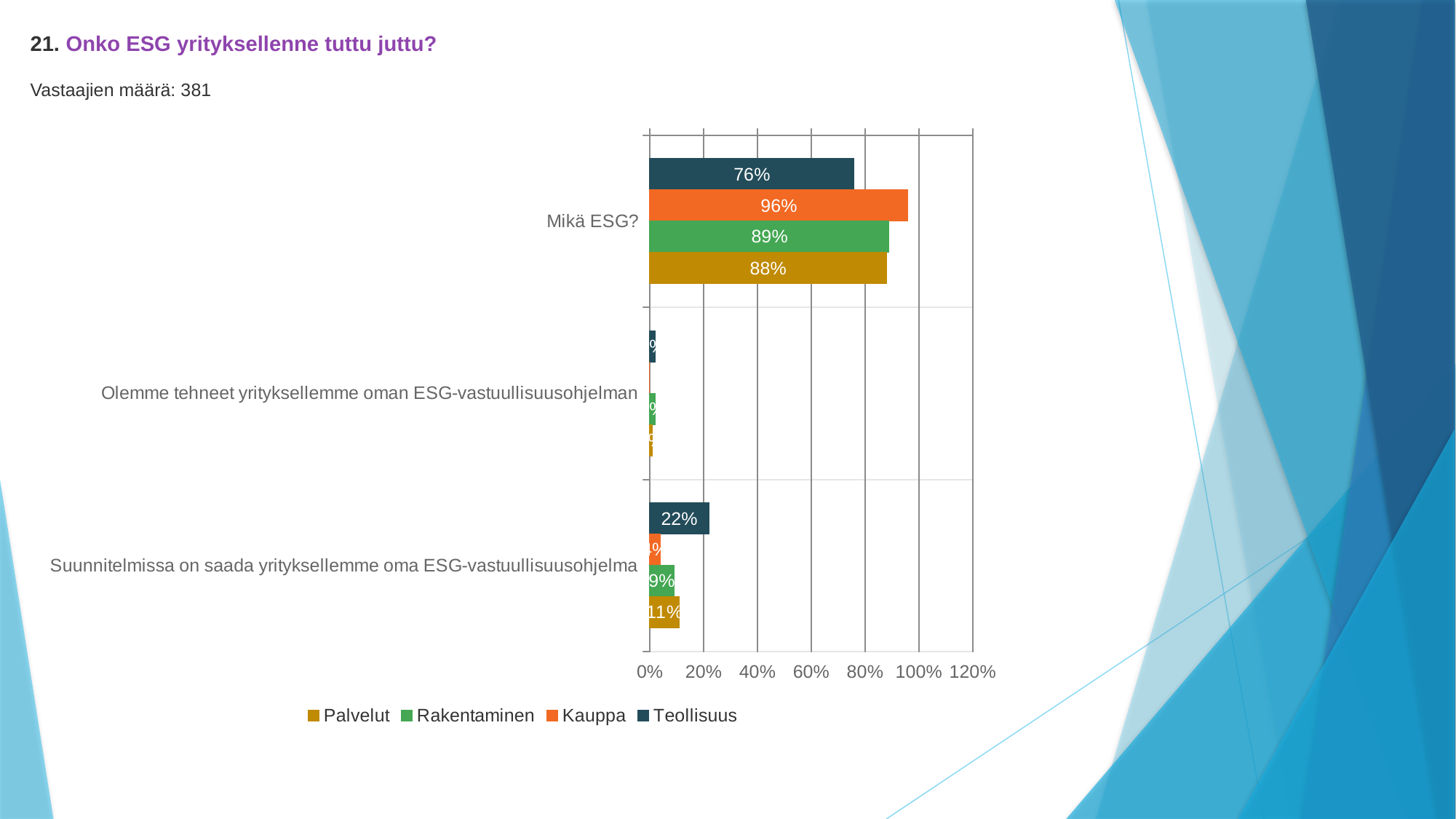
What is the difference between the Kauppa and Teollisuus values in the category "Mikä ESG?"? 20% Which series has the lowest value in the category "Mikä ESG?"? Teollisuus What is the value for Teollisuus in the category "Mikä ESG?"? 76% What is the value for Kauppa in the category "Mikä ESG?"? 96% Is the value for Teollisuus in the category "Suunnitelmissa on saada yrityksellemme oma ESG-vastuullisuusohjelma" greater or less than 40%? less What kind of chart is shown on the slide? bar chart What is the value for Teollisuus in the category "Suunnitelmissa on saada yrityksellemme oma ESG-vastuullisuusohjelma"? 22% Which series is shown in orange in the legend? Kauppa Which series has the highest value in the category "Mikä ESG?"? Kauppa How many series does the legend list? 4 How many categories are shown on the chart? 3 What is the value for Palvelut in the category "Mikä ESG?"? 88%